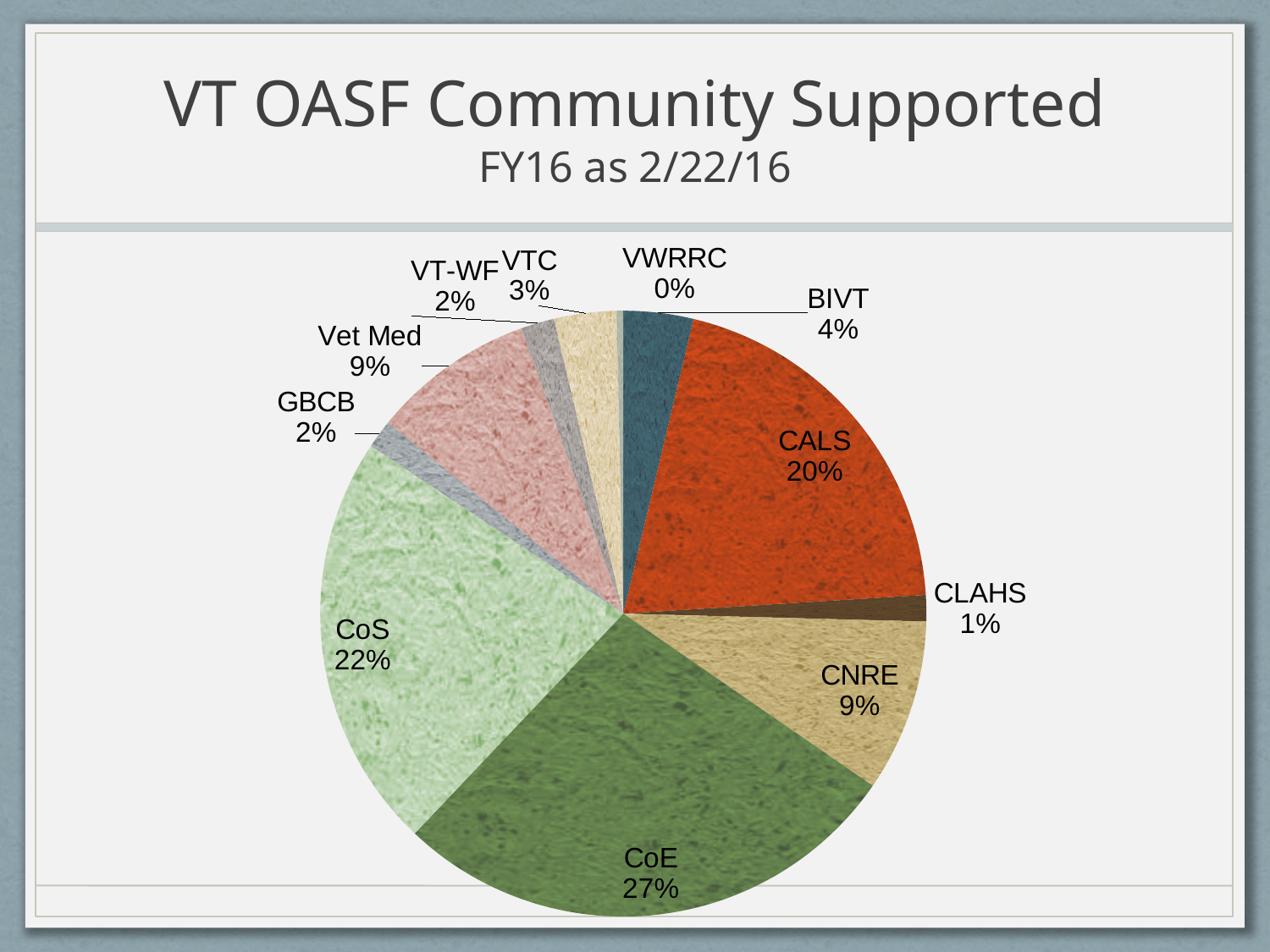
What share of the pie does CALS represent? 20% What is the value shown for CNRE? 9% What share of the pie does CoE represent? 27% How many categories are shown in the pie chart? 11 Which category has the smallest slice of the pie? VWRRC What is the title of the chart on the slide? VT OASF Community Supported FY16 as 2/22/16 What is the value shown for BIVT? 4% What is the difference between the shares of CoE and CoS? 5% What is the value shown for VTC? 3% What kind of chart is shown on the slide? pie chart Which category has the largest slice of the pie? CoE Which is larger, the share for CALS or the share for CoS? CoS